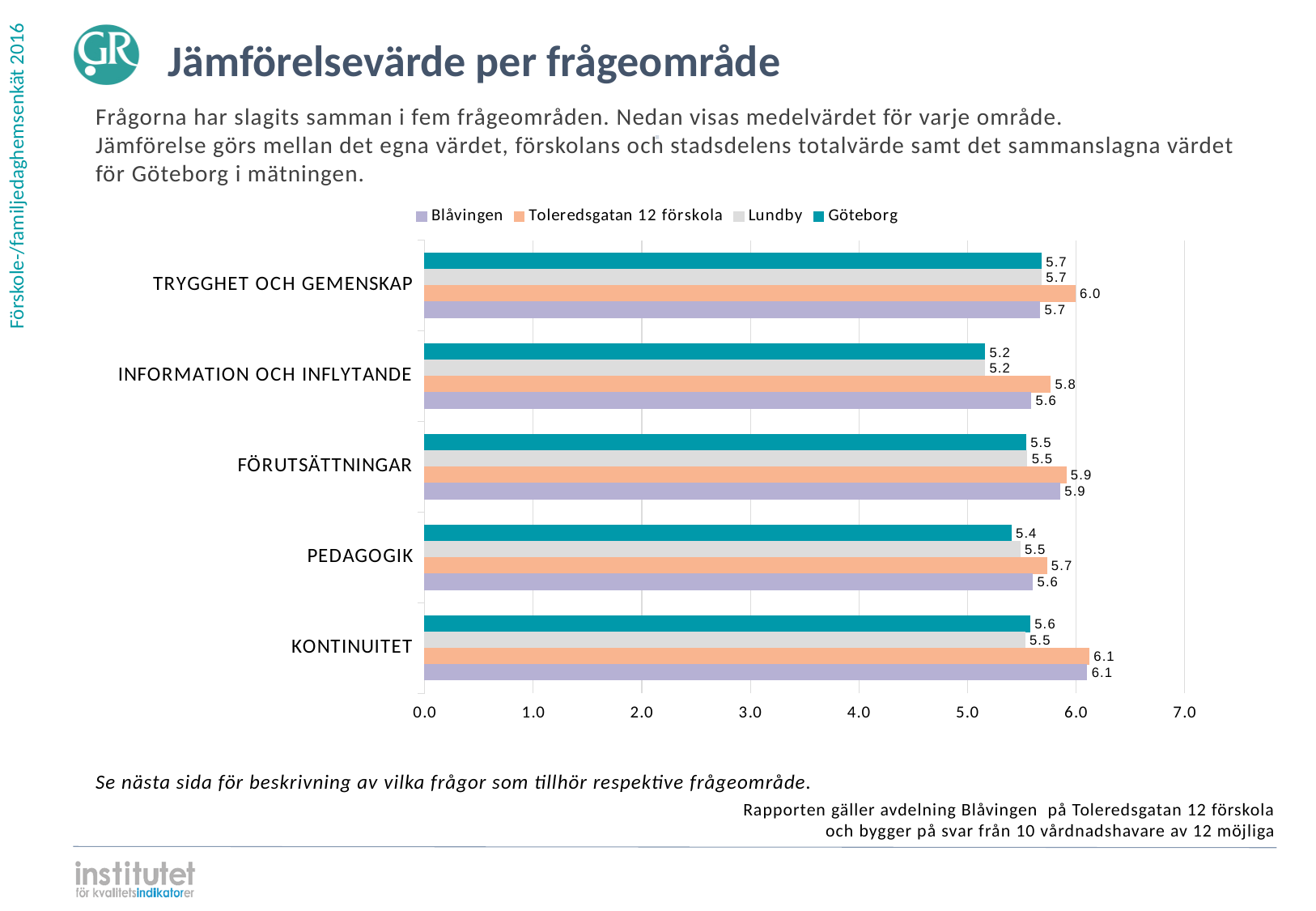
In which category does Blåvingen have its highest value? KONTINUITET Which series is shown in teal on the chart? Göteborg What is the value for Lundby in the PEDAGOGIK category? 5.5 Which is larger in the PEDAGOGIK category: the value for Blåvingen or the value for Göteborg? Blåvingen What is the value for Toleredsgatan 12 förskola in the TRYGGHET OCH GEMENSKAP category? 6.0 How many series does the legend list? 4 What is the value for Göteborg in the INFORMATION OCH INFLYTANDE category? 5.2 What is the value for Blåvingen in the KONTINUITET category? 6.1 What kind of chart is shown on the slide? Bar chart In which category does Göteborg have its lowest value? INFORMATION OCH INFLYTANDE How many categories are shown on the chart? 5 What is the difference between the Toleredsgatan 12 förskola value and the Göteborg value in the INFORMATION OCH INFLYTANDE category? 0.6